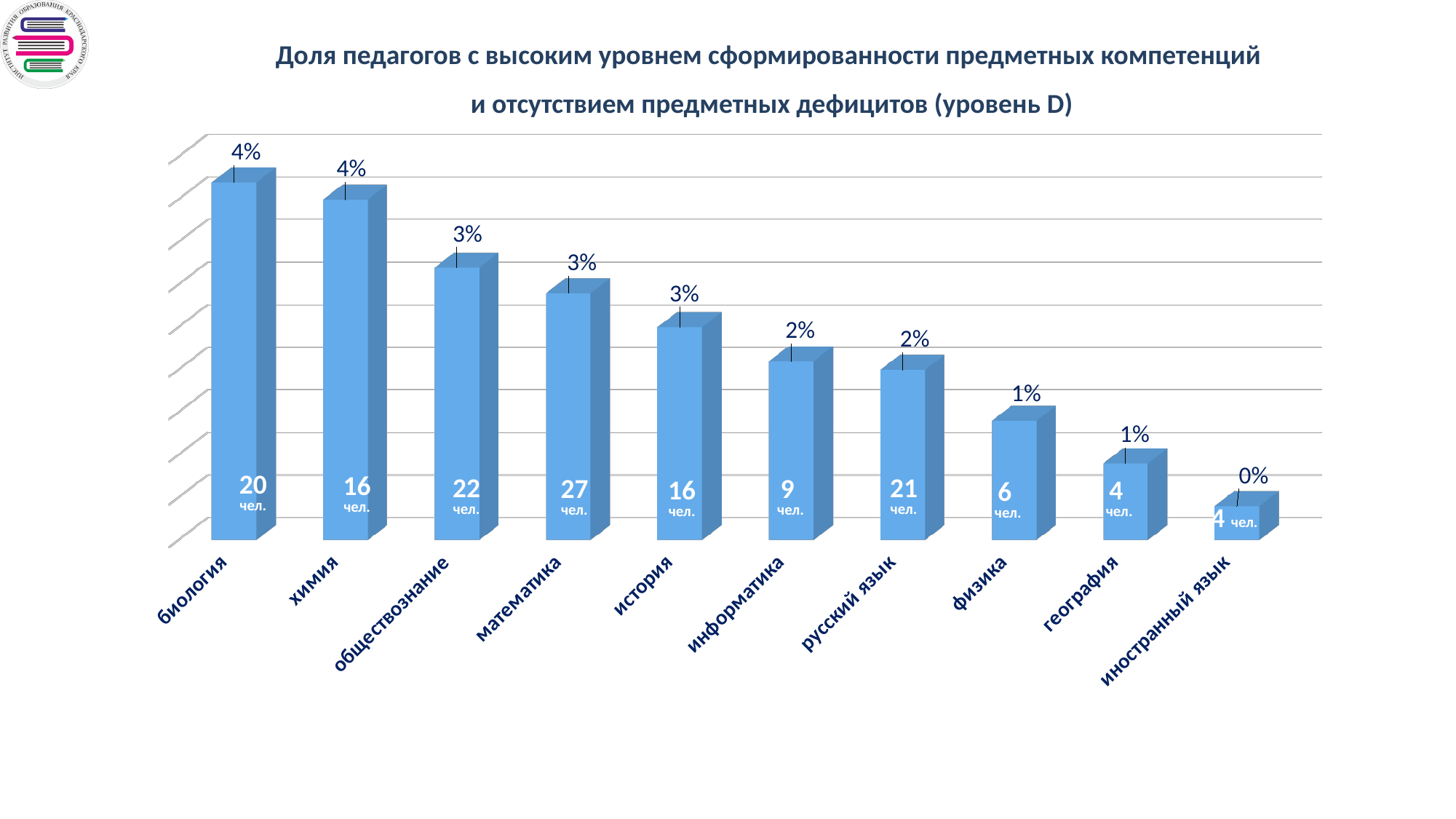
What is the difference in the number of people between математика and биология? 7 чел. What percentage is shown for биология? 4% Which subject has the lowest percentage? иностранный язык What kind of chart is this? bar chart How many people (чел.) are shown for русский язык? 21 чел. How many people (чел.) are shown for математика? 27 чел. What percentage is shown for география? 1% What percentage is shown for информатика? 2% How many subjects are shown on the chart? 10 Which has more people: обществознание or история? обществознание Do the percentages rise or fall from left to right along the x axis? fall Which subject has the largest number of people (чел.)? математика